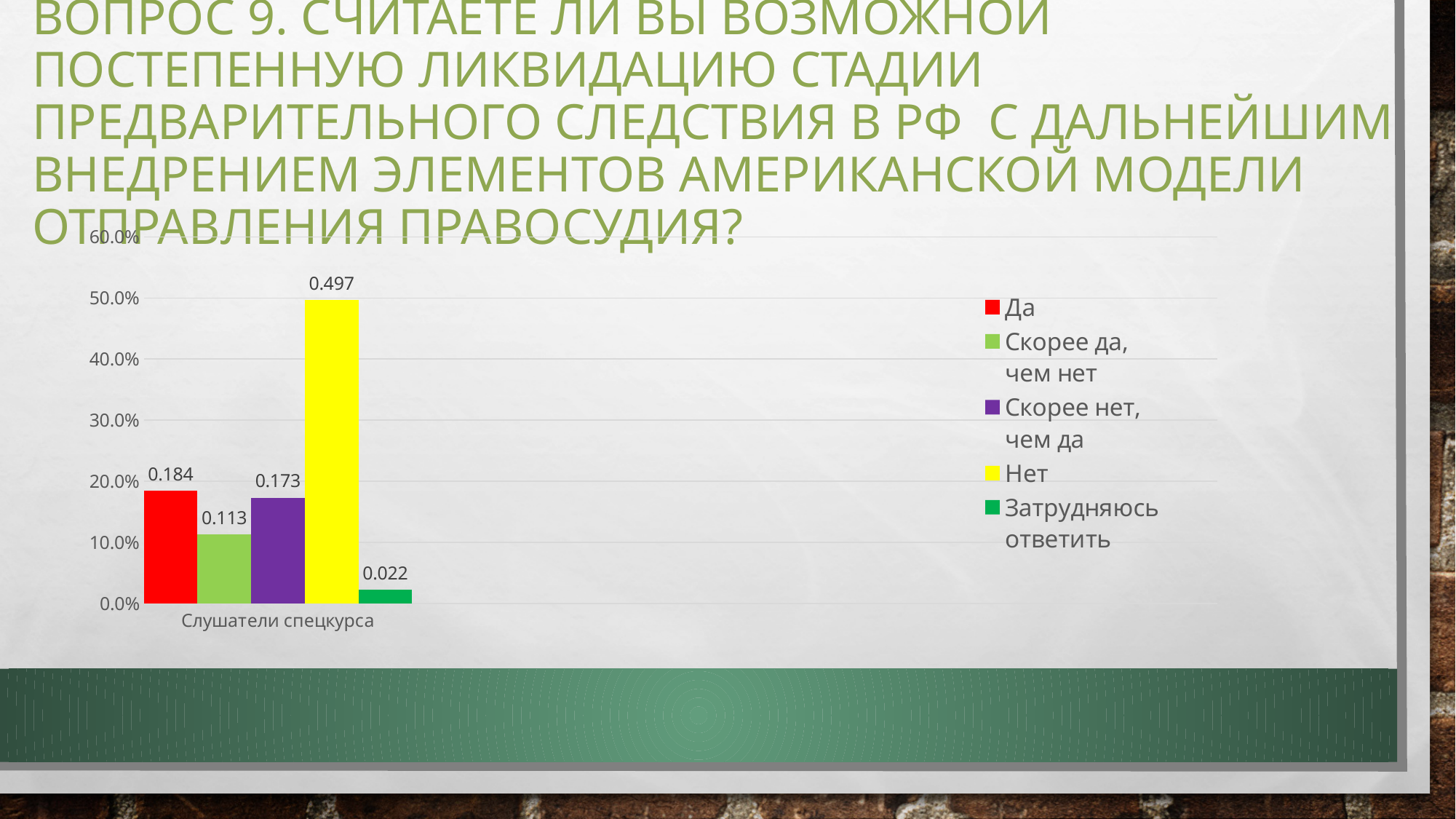
Which is larger, the value for "Да" or the value for "Скорее нет, чем да"? Да What is the difference between the values for "Нет" and "Да"? 0.313 What value is shown for the series "Скорее да, чем нет"? 0.113 What value is shown for the series "Нет"? 0.497 What value is shown for the series "Затрудняюсь ответить"? 0.022 What is the label of the category on the x axis? Слушатели спецкурса What value is shown for the series "Да"? 0.184 Which series has the lowest value? Затрудняюсь ответить Is the value for "Нет" greater or less than 40.0%? greater What kind of chart is shown on the slide? bar chart How many series does the legend list? 5 Which series has the highest value? Нет